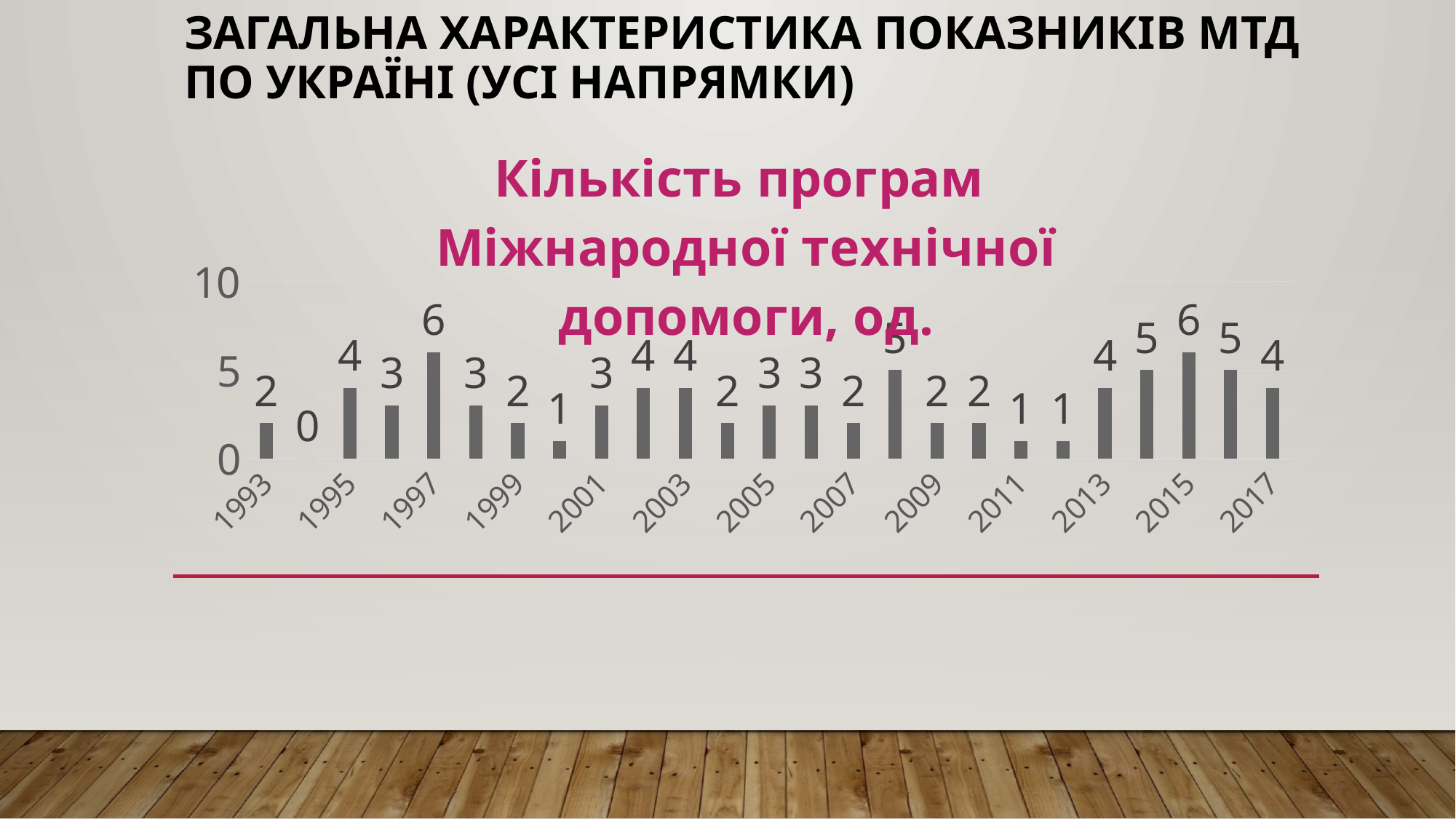
What is the difference between the values for 1997 and 2017? 2 What is the difference between the values for 2015 and 2011? 5 What is the highest value shown on the chart? 6 What is the value for 1993? 2 What is the value for 2011? 1 What is the lowest value shown on the chart? 0 Is the value for 2015 greater or less than 5? greater Which year has the larger value, 1995 or 1999? 1995 What is the value for 2013? 4 How many bars are plotted on the chart? 25 What is the value for 1997? 6 What kind of chart is shown on the slide? bar chart